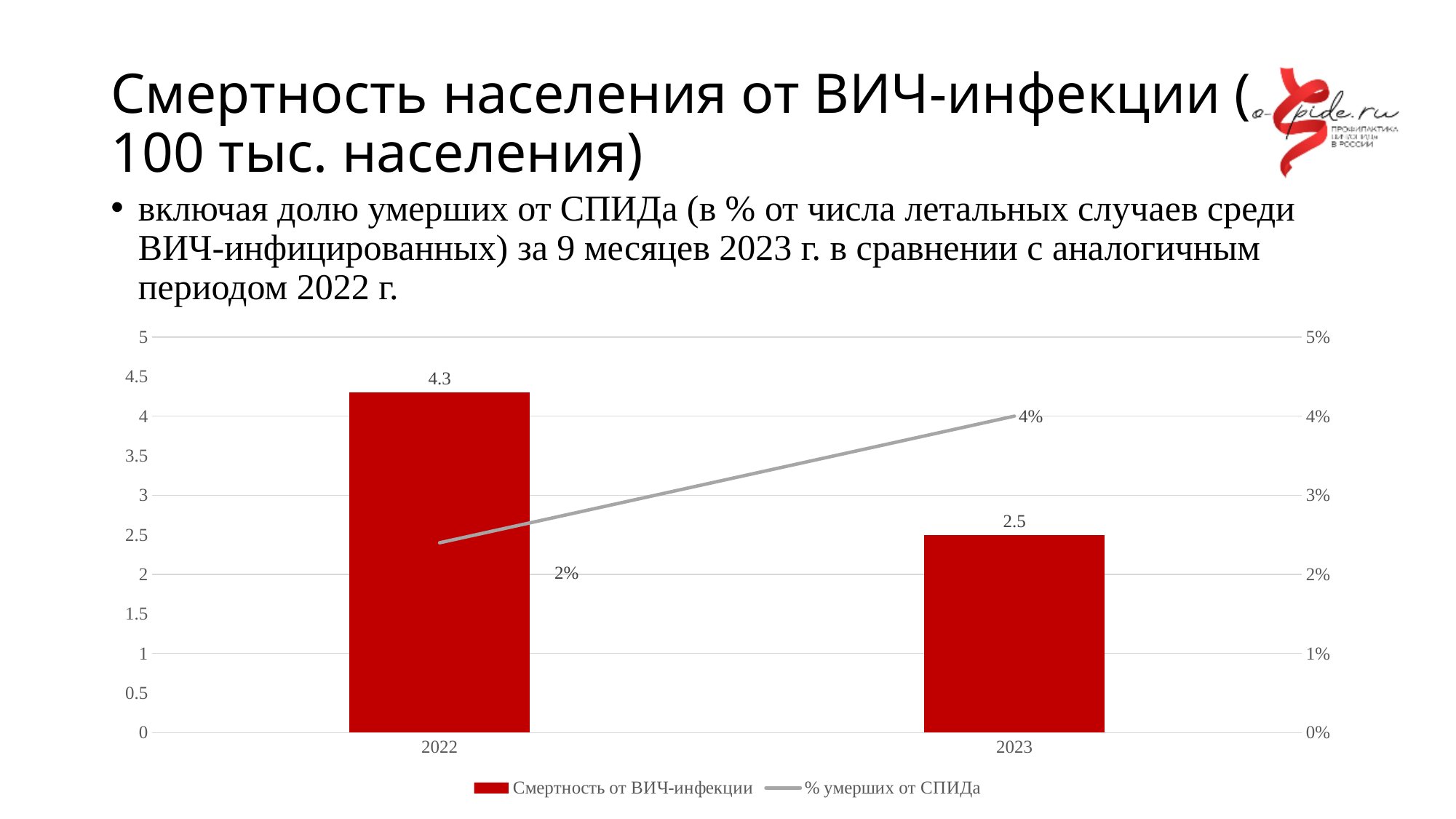
What is the value of "% умерших от СПИДа" for 2022? 2% Is the "Смертность от ВИЧ-инфекции" value for 2022 larger or smaller than the value for 2023? larger What is the value of the "Смертность от ВИЧ-инфекции" bar for 2022? 4.3 What is the difference between the "Смертность от ВИЧ-инфекции" values for 2022 and 2023? 1.8 What is the value of "% умерших от СПИДа" for 2023? 4% What is the difference between the "% умерших от СПИДа" values for 2023 and 2022? 2% Does the "% умерших от СПИДа" line rise or fall from 2022 to 2023? rise How many series does the chart legend list? 2 Which year has the lower "% умерших от СПИДа" value? 2022 Which year has the higher "Смертность от ВИЧ-инфекции" value? 2022 What is the value of the "Смертность от ВИЧ-инфекции" bar for 2023? 2.5 How many years (categories) are shown on the x axis of the chart? 2